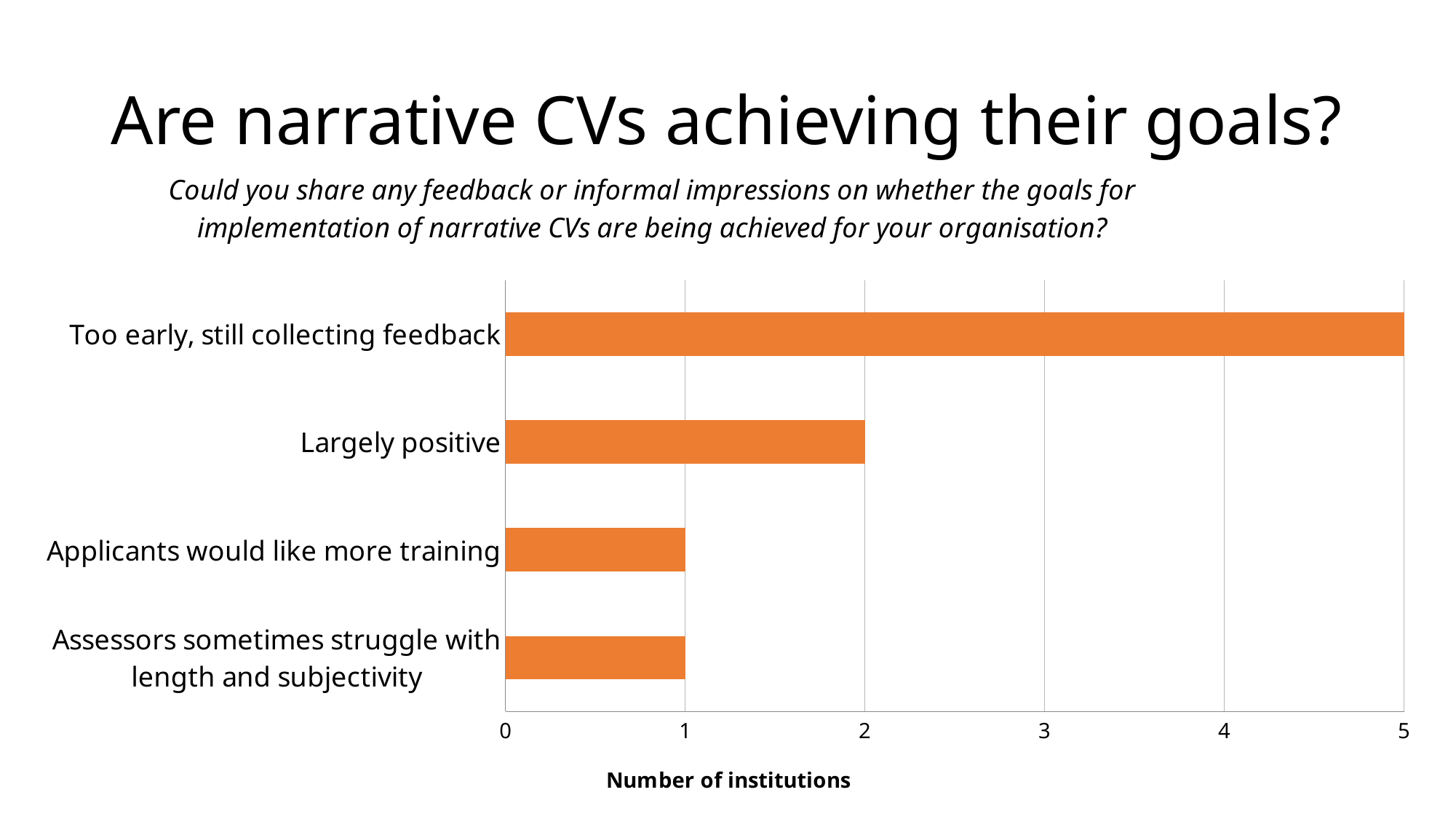
Which has more institutions: "Largely positive" or "Applicants would like more training"? Largely positive Which category has the highest number of institutions? Too early, still collecting feedback What is the number of institutions for "Applicants would like more training"? 1 How many categories does the chart show? 4 What is the number of institutions for "Too early, still collecting feedback"? 5 What is the number of institutions for "Largely positive"? 2 What is the difference in number of institutions between "Too early, still collecting feedback" and "Largely positive"? 3 What is the number of institutions for "Assessors sometimes struggle with length and subjectivity"? 1 What is the label of the horizontal axis? Number of institutions What kind of chart is shown on the slide? bar chart What colour are the bars in the chart? orange Is the value for "Too early, still collecting feedback" greater or less than 3? greater